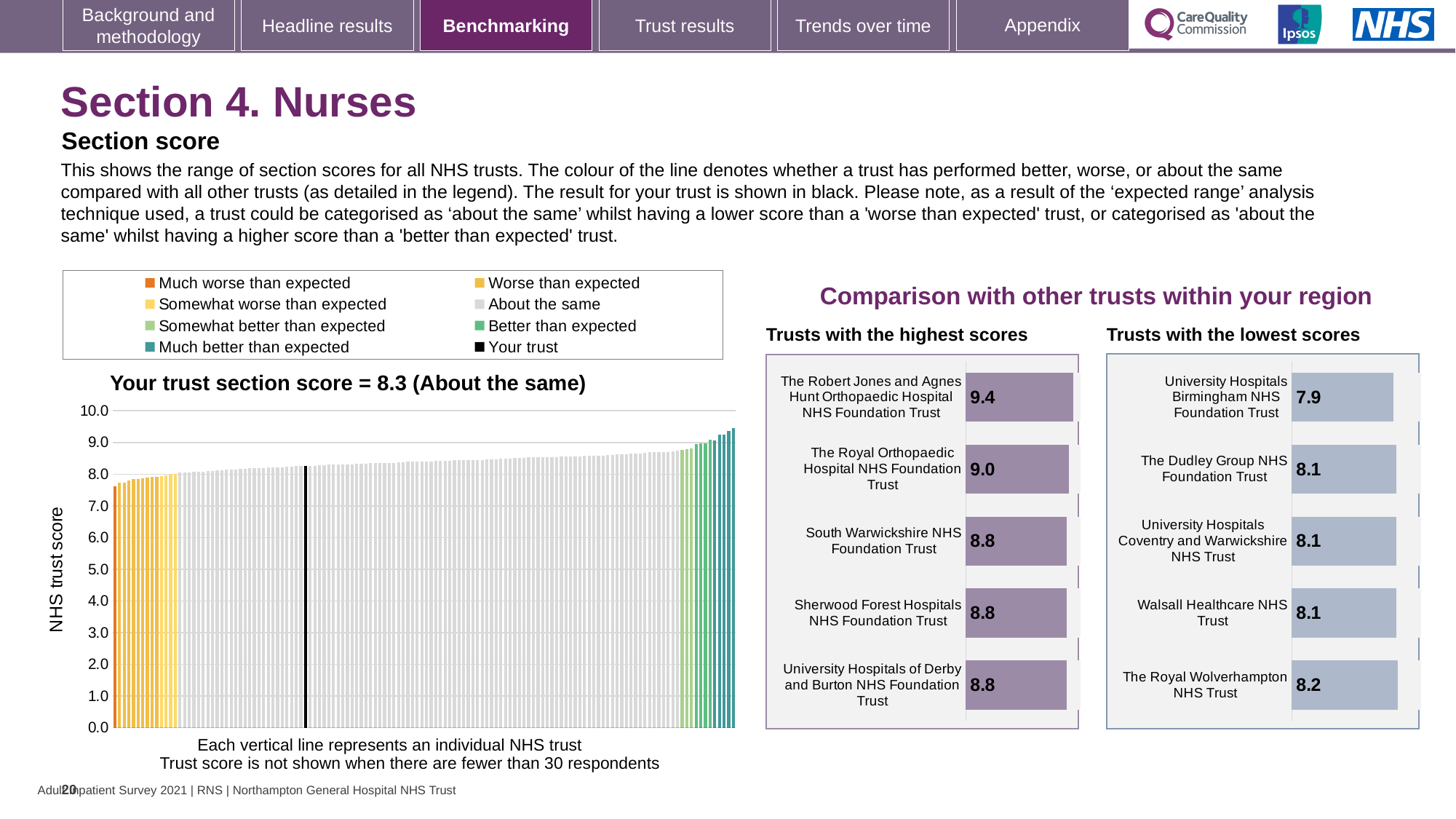
In the 'Trusts with the lowest scores' chart, what is the score for University Hospitals Birmingham NHS Foundation Trust? 7.9 What kind of chart is the main chart on the left showing the range of section scores? Bar chart In the 'Trusts with the lowest scores' chart, which trust has the lowest score? University Hospitals Birmingham NHS Foundation Trust In the main chart on the left, what is your trust's section score? 8.3 In the 'Trusts with the highest scores' chart, which trust has the highest score? The Robert Jones and Agnes Hunt Orthopaedic Hospital NHS Foundation Trust In the 'Trusts with the lowest scores' chart, what is the score for The Royal Wolverhampton NHS Trust? 8.2 In the 'Trusts with the lowest scores' chart, which has the larger score: The Royal Wolverhampton NHS Trust or University Hospitals Birmingham NHS Foundation Trust? The Royal Wolverhampton NHS Trust In the 'Trusts with the highest scores' chart, what is the difference between the scores of The Robert Jones and Agnes Hunt Orthopaedic Hospital NHS Foundation Trust and The Royal Orthopaedic Hospital NHS Foundation Trust? 0.4 In the 'Trusts with the lowest scores' chart, what is the difference between the scores of The Royal Wolverhampton NHS Trust and University Hospitals Birmingham NHS Foundation Trust? 0.3 How many trusts are listed in the 'Trusts with the highest scores' chart? 5 In the main chart on the left, do the trust scores rise or fall from left to right? Rise In the 'Trusts with the highest scores' chart, what is the score for The Robert Jones and Agnes Hunt Orthopaedic Hospital NHS Foundation Trust? 9.4